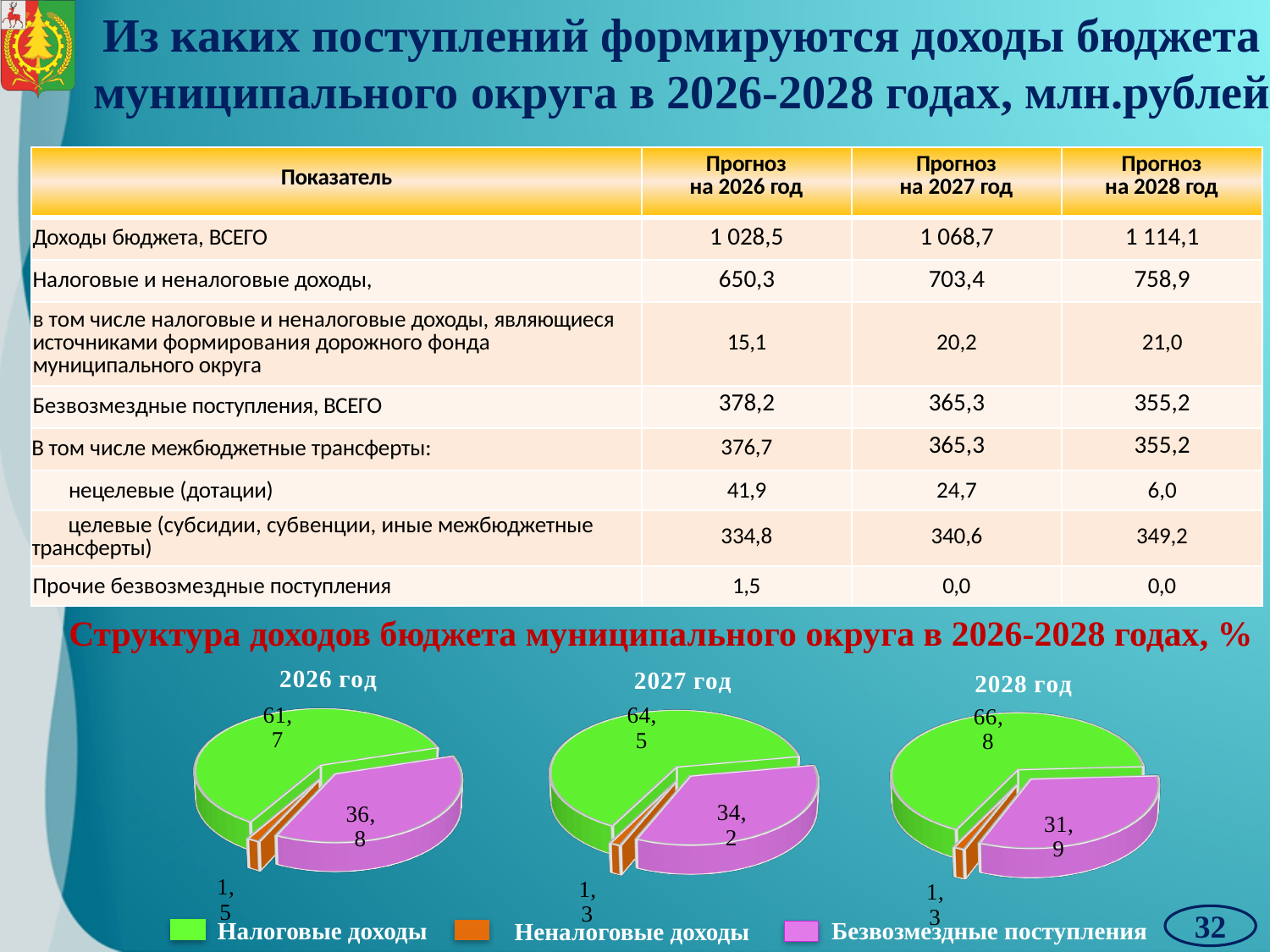
In the 2028 год pie chart, what share is shown for Неналоговые доходы? 1,3 In the 2028 год pie chart, which category has the largest slice? Налоговые доходы In the 2027 год pie chart, what share is shown for Безвозмездные поступления? 34,2 In the 2026 год pie chart, which category has the smallest slice? Неналоговые доходы What colour represents Безвозмездные поступления in the pie charts? Pink What type of chart is used to show the structure of budget revenues for 2026-2028? Pie chart Is the Безвозмездные поступления share larger in the 2026 год pie chart or in the 2028 год pie chart? 2026 год Across the 2026, 2027 and 2028 pie charts, does the Налоговые доходы share rise or fall from year to year? Rise How many categories does the legend below the pie charts list? 3 How many slices does each pie chart on the slide have? 3 In the 2026 год pie chart, what share is shown for Налоговые доходы? 61,7 In the 2027 год pie chart, what is the difference between the Налоговые доходы share and the Безвозмездные поступления share? 30,3